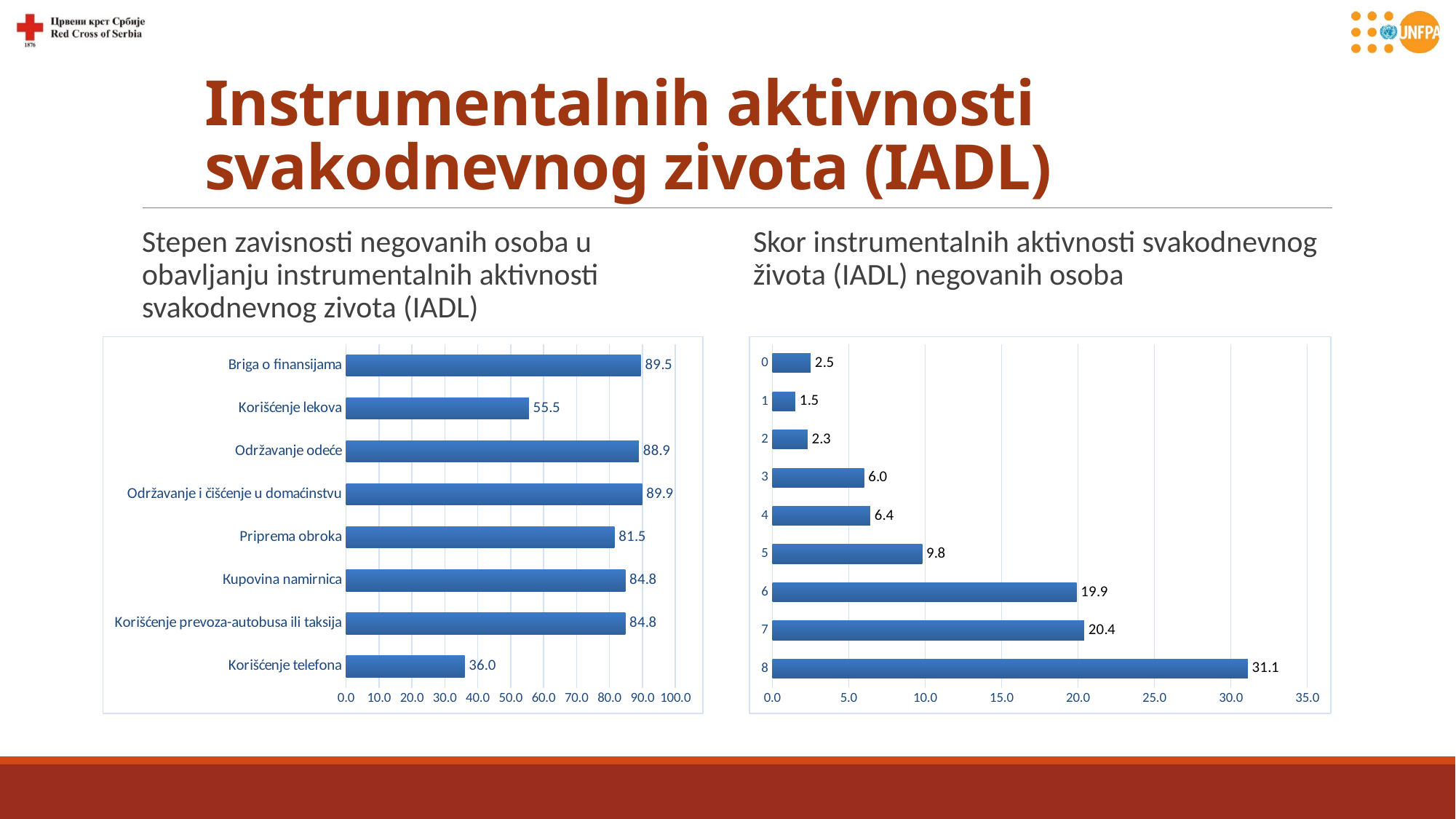
In the right chart, which category has the lowest value? 1 In the left chart, how many categories are shown? 8 In the right chart, what is the difference between category 7 and category 6? 0.5 In the right chart, what is the value for category 8? 31.1 In the left chart, what is the value for Korišćenje lekova? 55.5 In the left chart, what is the difference between Briga o finansijama and Korišćenje telefona? 53.5 In the left chart, which is larger: Priprema obroka or Kupovina namirnica? Kupovina namirnica In the right chart, do the values generally rise or fall from category 0 to category 8? Rise In the left chart, what is the value for Održavanje i čišćenje u domaćinstvu? 89.9 What type of chart is the right chart? Bar chart In the right chart, which category has the highest value? 8 In the left chart, which category has the lowest value? Korišćenje telefona